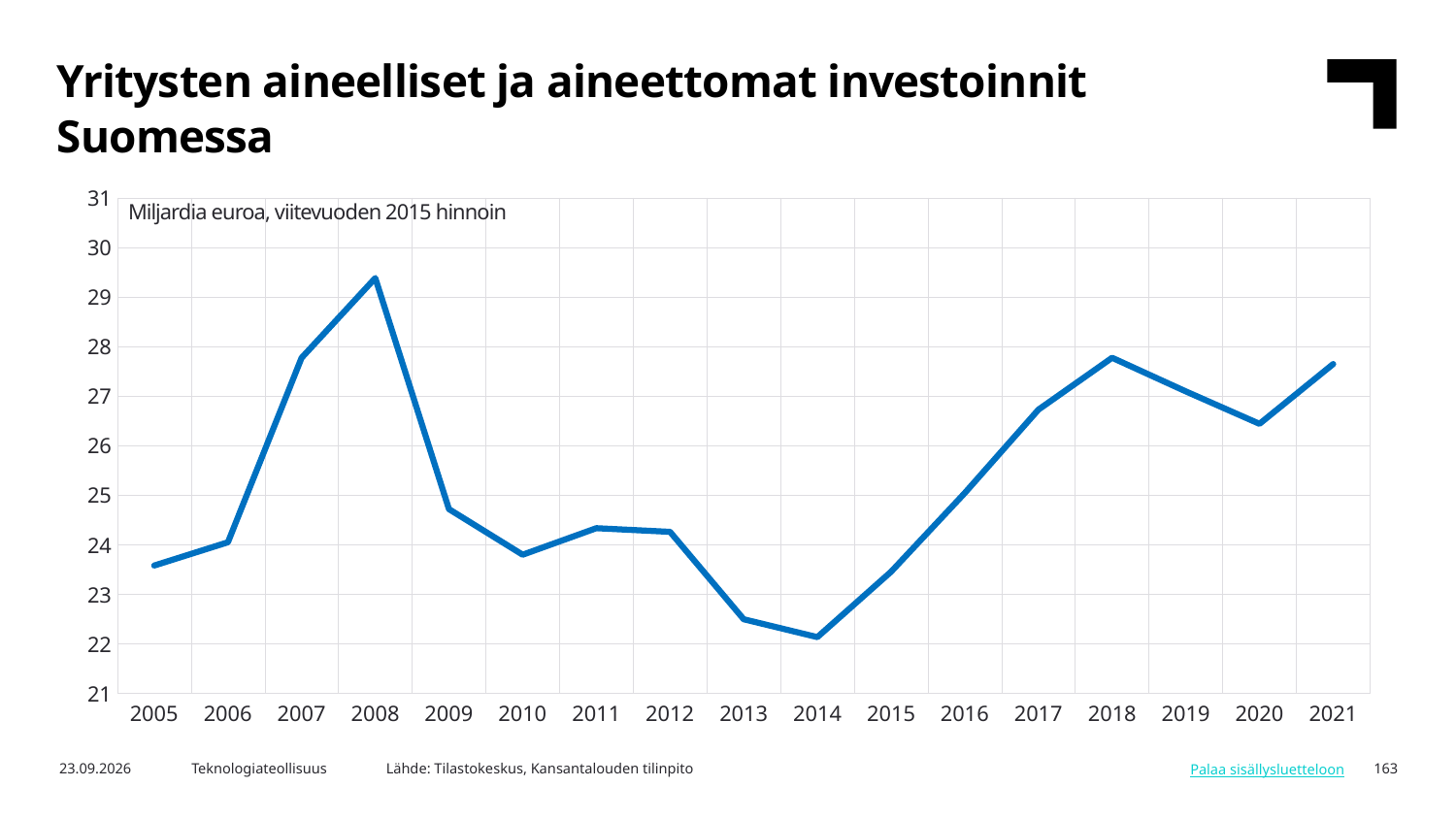
Which year has the larger value, 2020 or 2021? 2021 Is the value for 2018 greater or less than 27? greater In which year is the value highest? 2008 What unit is stated in the label inside the chart area? Miljardia euroa, viitevuoden 2015 hinnoin How many years are plotted along the x axis? 17 In which year is the value lowest? 2014 Is the value for 2008 greater or less than 29? greater Is the value for 2005 greater or less than 24? less What kind of chart is shown on the slide? line chart Which year has the larger value, 2007 or 2009? 2007 Do the values rise or fall from 2014 to 2018? rise